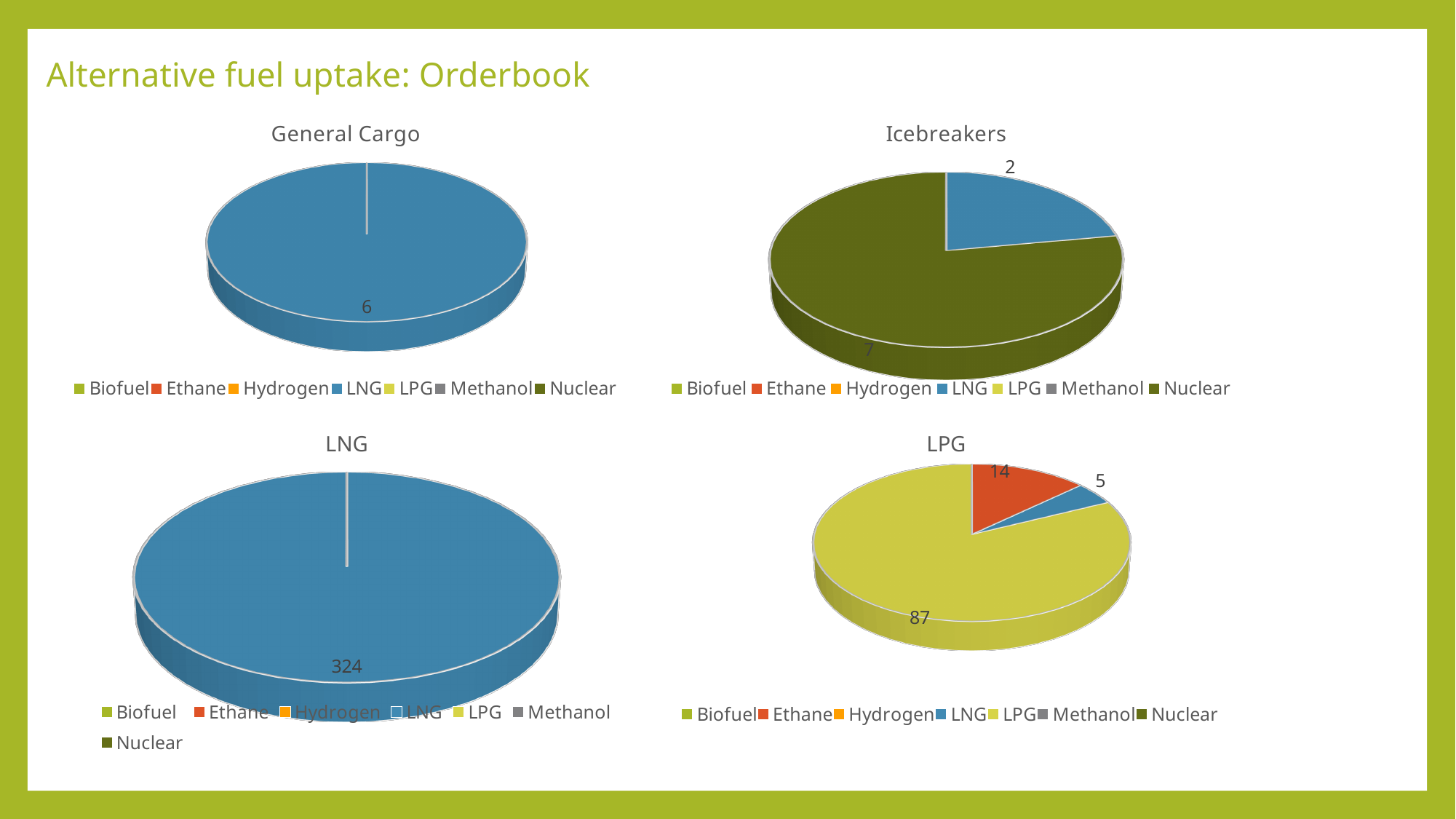
In the Icebreakers chart, what is the difference between the Nuclear and LNG values? 5 In the LPG chart, what is the total of the three labelled slices? 106 What type of chart is the Icebreakers chart? Pie chart In the LPG chart, which fuel has the smallest slice? LNG In the LNG chart, what value is shown for LNG? 324 In the LPG chart, what value is shown for Ethane? 14 In the General Cargo chart, what value is shown for LNG? 6 In the LPG chart, which is larger, Ethane or LNG? Ethane In the LPG chart, what value is shown for LPG? 87 In the Icebreakers chart, what value is shown for LNG? 2 In the Icebreakers chart, what value is shown for Nuclear? 7 In the LPG chart, which fuel has the largest slice? LPG